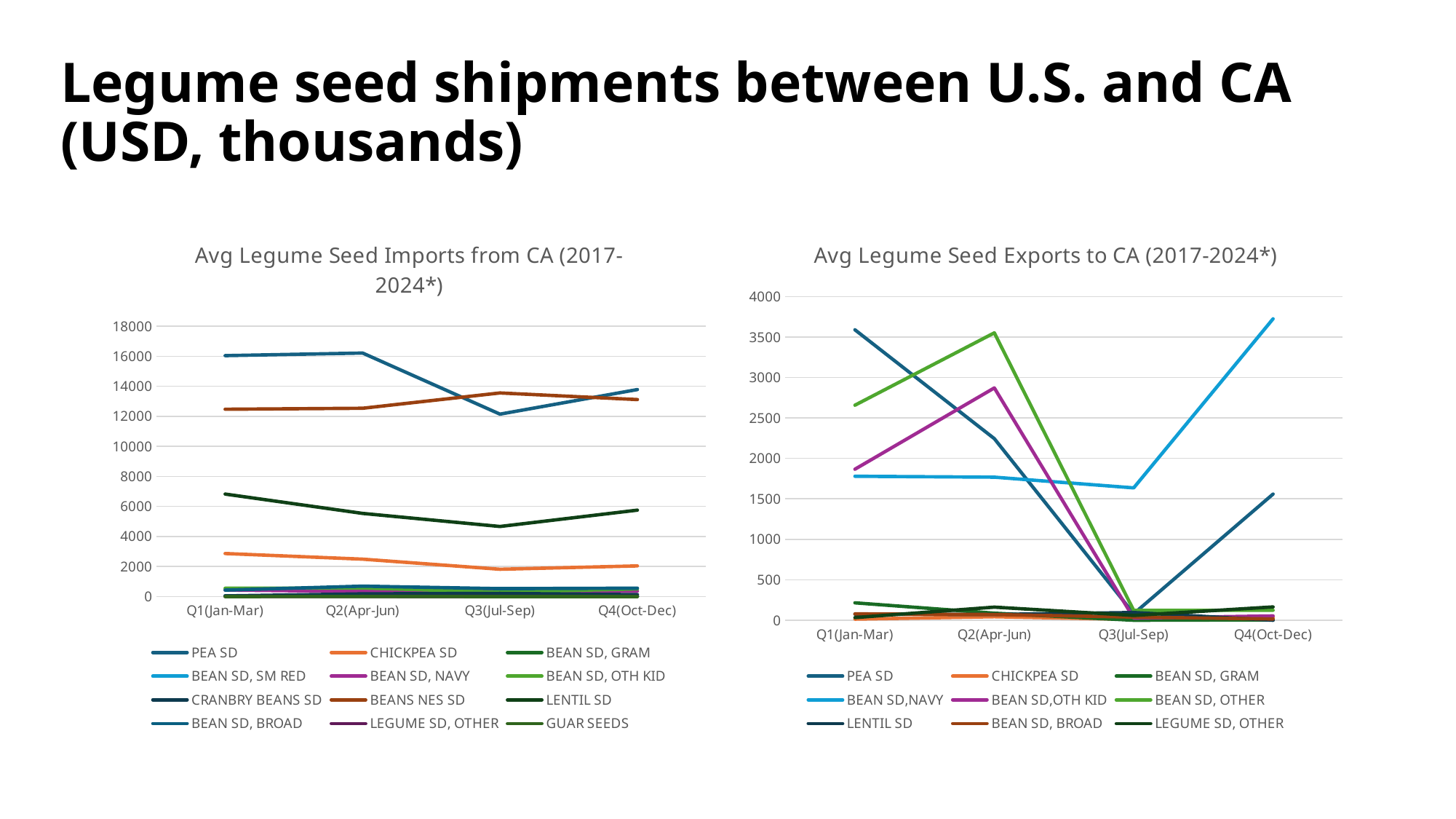
In the 'Avg Legume Seed Imports from CA (2017-2024*)' chart, which is larger in Q3(Jul-Sep): PEA SD or BEANS NES SD? BEANS NES SD What kind of chart is the 'Avg Legume Seed Imports from CA (2017-2024*)' chart? line chart In the 'Avg Legume Seed Exports to CA (2017-2024*)' chart, is the value for BEAN SD,NAVY in Q4(Oct-Dec) greater or less than 3500? greater How many series does the legend of the 'Avg Legume Seed Exports to CA (2017-2024*)' chart list? 9 In the 'Avg Legume Seed Exports to CA (2017-2024*)' chart, does BEAN SD, OTHER rise or fall from Q1(Jan-Mar) to Q2(Apr-Jun)? rise In the 'Avg Legume Seed Exports to CA (2017-2024*)' chart, in which quarter is PEA SD highest? Q1(Jan-Mar) What is the title of the chart on the right side of the slide? Avg Legume Seed Exports to CA (2017-2024*) In the 'Avg Legume Seed Imports from CA (2017-2024*)' chart, is the value for LENTIL SD in Q3(Jul-Sep) greater or less than 6000? less How many series does the legend of the 'Avg Legume Seed Imports from CA (2017-2024*)' chart list? 12 In the 'Avg Legume Seed Imports from CA (2017-2024*)' chart, is the value for PEA SD in Q1(Jan-Mar) greater or less than 14000? greater In the 'Avg Legume Seed Imports from CA (2017-2024*)' chart, how many quarters are shown on the x axis? 4 In the 'Avg Legume Seed Exports to CA (2017-2024*)' chart, which series has the highest value in Q4(Oct-Dec)? BEAN SD,NAVY